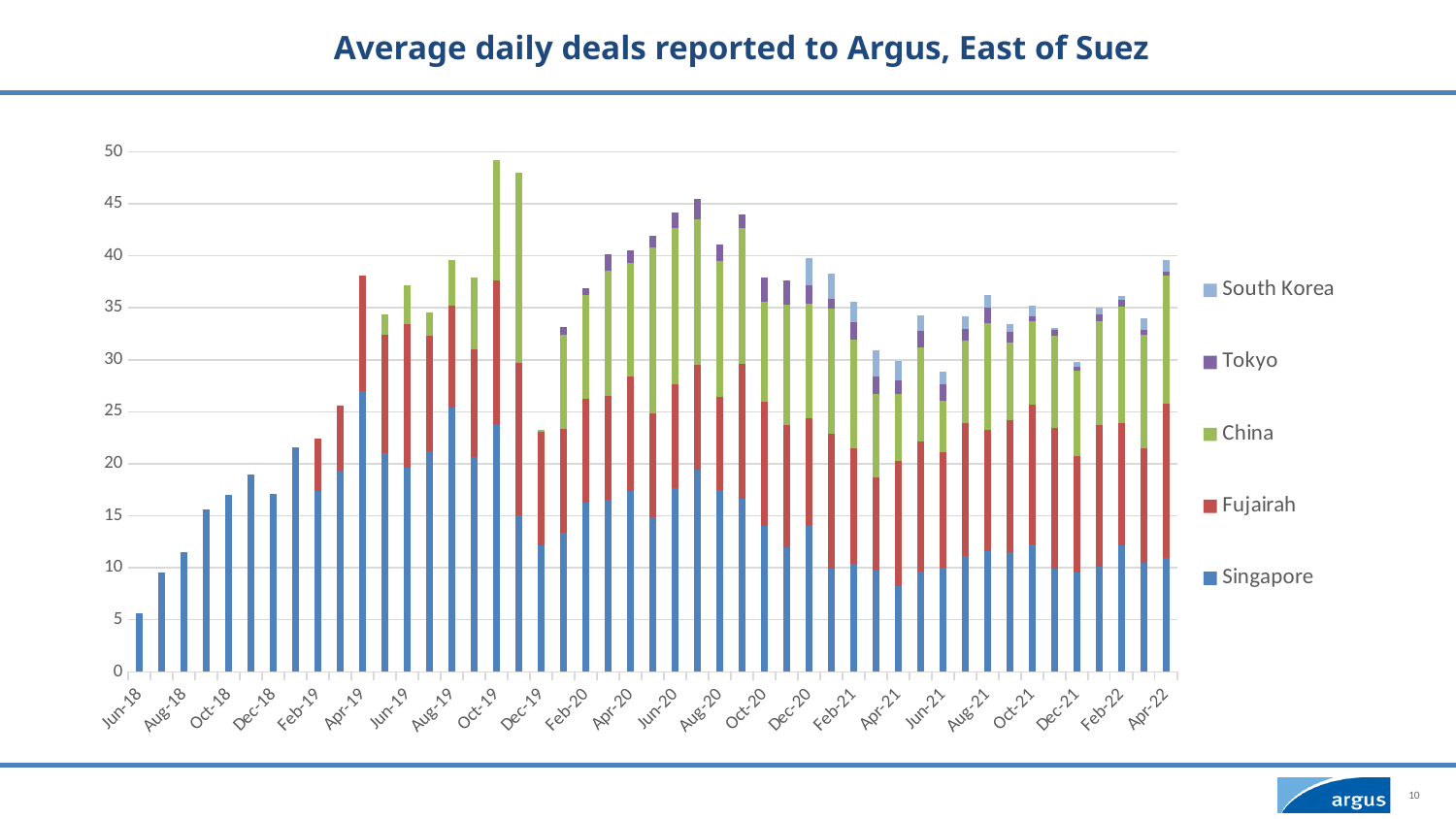
How many series does the legend list? 5 Is the total value for Dec-19 greater or less than 25? less Which month has a larger total, Oct-19 or Dec-19? Oct-19 Which series is shown in green in the chart? China What kind of chart is shown on the slide? Stacked bar chart Is the total value for Apr-21 greater or less than 35? less Which month has the shortest stacked bar? Jun-18 What is the title of the chart? Average daily deals reported to Argus, East of Suez Which month has the tallest stacked bar? Oct-19 Is the total value for Jun-18 greater or less than 10? less Do the total values rise or fall from Jun-18 to Apr-19? rise